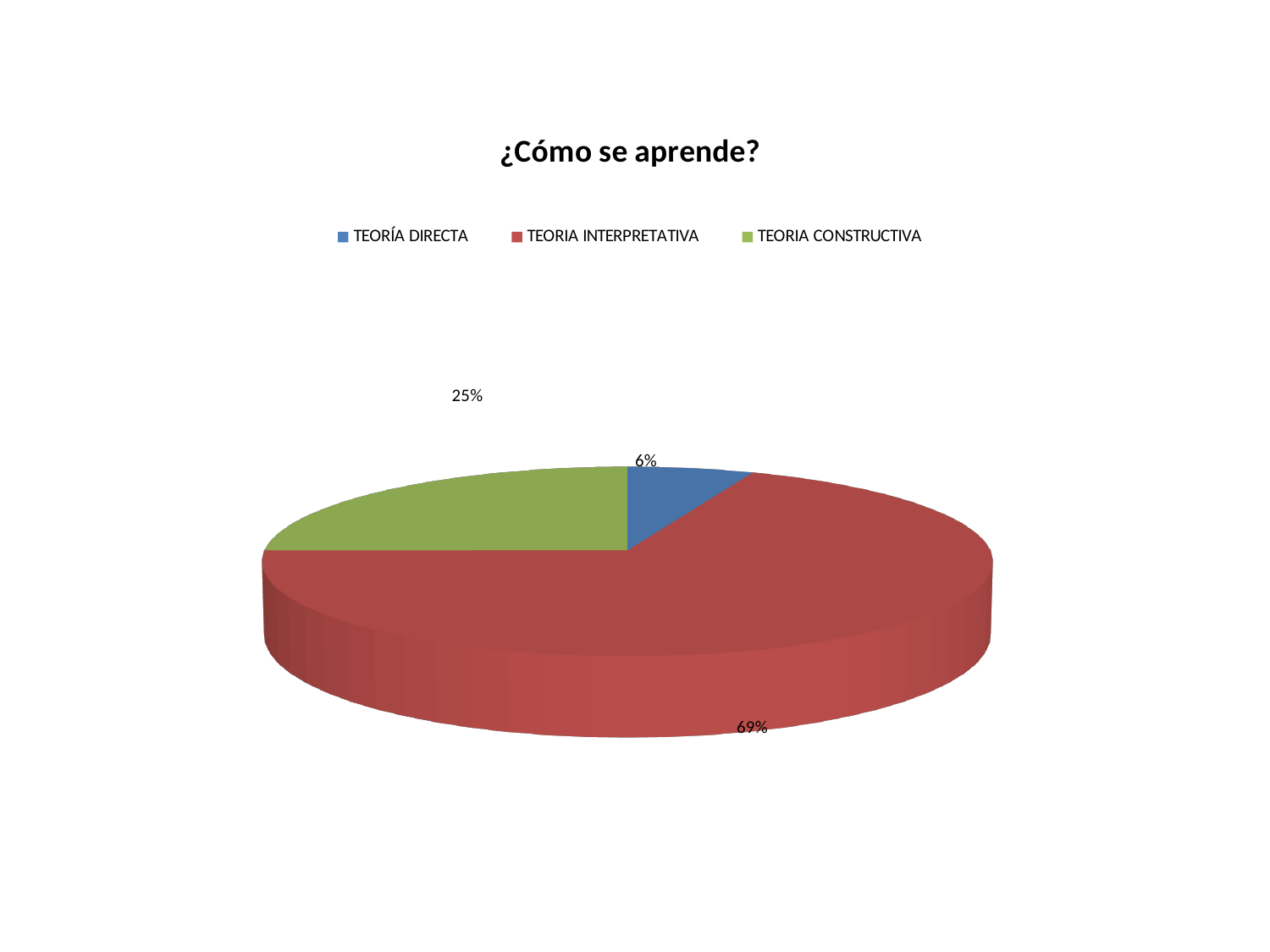
What kind of chart is shown on the slide? Pie chart What percentage does the TEORIA CONSTRUCTIVA slice show? 25% What percentage does the TEORIA INTERPRETATIVA slice show? 69% What is the difference in percentage points between TEORIA INTERPRETATIVA and TEORIA CONSTRUCTIVA? 44 How many slices does the pie chart have? 3 Which category has the smallest share of the pie? TEORÍA DIRECTA What is the title of the chart? ¿Cómo se aprende? Which category has the largest share of the pie? TEORIA INTERPRETATIVA What is the difference in percentage points between TEORIA CONSTRUCTIVA and TEORÍA DIRECTA? 19 What percentage does the TEORÍA DIRECTA slice show? 6% Which is larger, the share for TEORIA CONSTRUCTIVA or the share for TEORÍA DIRECTA? TEORIA CONSTRUCTIVA Which colour represents TEORIA CONSTRUCTIVA in the legend? Green